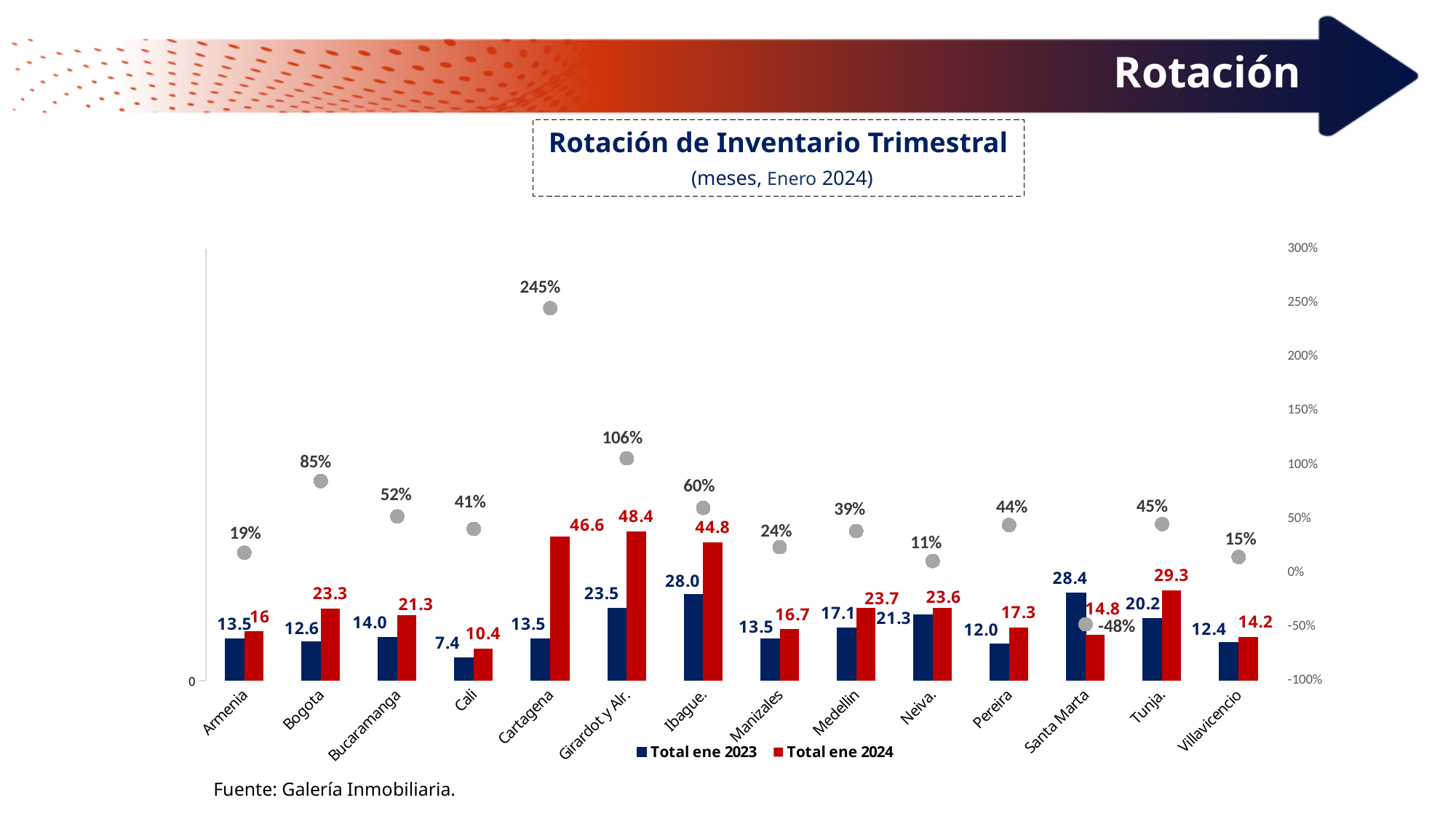
What percentage change is shown above the bars for Cartagena? 245% How many cities are shown on the x axis of the chart? 14 Which city has the lowest Total ene 2023 value? Cali What is the Total ene 2024 value for Tunja.? 29.3 How many series does the legend list? 2 Which colour represents the Total ene 2024 series? Red What is the Total ene 2023 value for Santa Marta? 28.4 What is the Total ene 2024 value for Cartagena? 46.6 What is the difference between the Total ene 2024 and Total ene 2023 values for Bogota? 10.7 Which city has the highest Total ene 2024 value? Girardot y Alr. Which is larger for Santa Marta: the Total ene 2023 value or the Total ene 2024 value? Total ene 2023 What kind of chart is used to show the Total ene 2023 and Total ene 2024 values? Bar chart